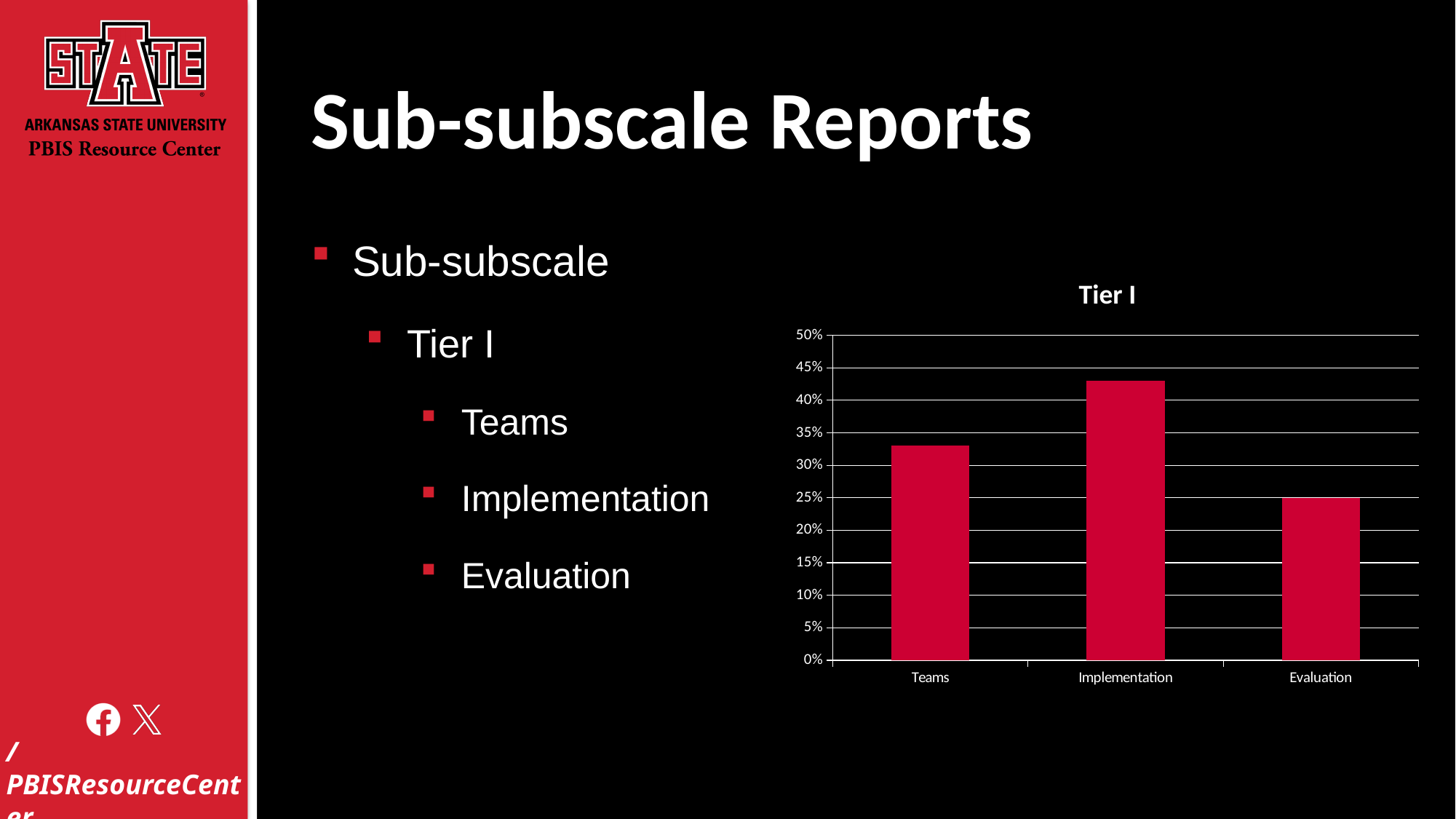
Is the value for Teams greater or less than 30%? greater Is the value for Implementation greater or less than 40%? greater What is the value for Evaluation in the Tier I chart? 25% What kind of chart is shown on the slide? bar chart Does the value rise or fall from Implementation to Evaluation? fall Is the value for Implementation greater or less than 45%? less Which is larger, the value for Teams or the value for Evaluation? Teams Which category has the highest value in the Tier I chart? Implementation Which category has the lowest value in the Tier I chart? Evaluation What is the title of the chart? Tier I How many categories are plotted in the Tier I chart? 3